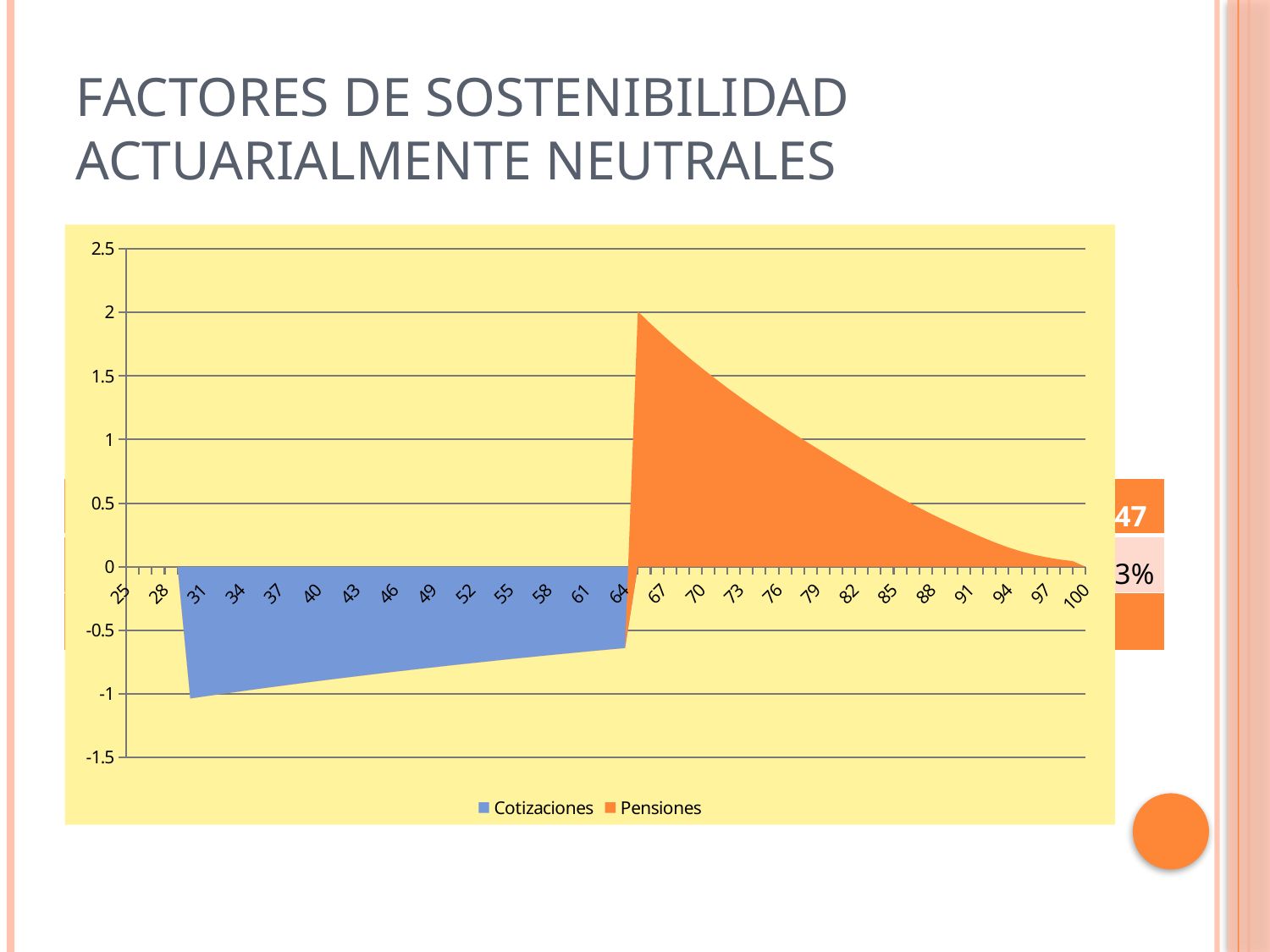
Which series is drawn in orange? Pensiones Do the Pensiones values rise or fall from 67 to 100 along the x axis? fall What are the two series named in the legend? Cotizaciones and Pensiones How many series does the legend list? 2 Is the value for Pensiones at 67 greater or less than 1.5? greater Is the value for Cotizaciones at 46 greater or less than -0.5? less What kind of chart is shown on the slide? area chart Is the value for Pensiones at 91 greater or less than 0.5? less Which series has negative values? Cotizaciones Do the Cotizaciones values rise or fall from 31 to 64 along the x axis? rise How many labels are shown on the x axis? 26